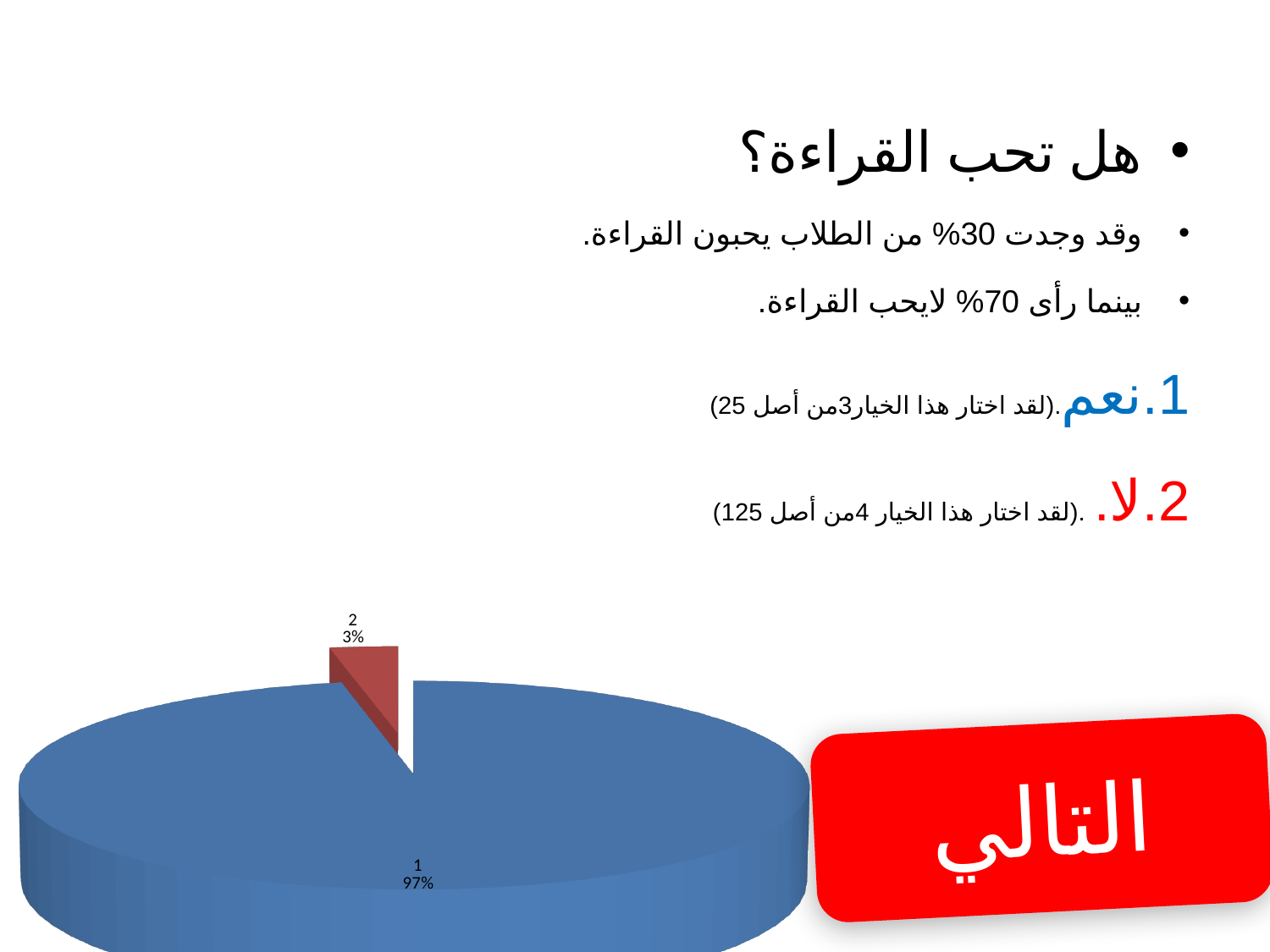
Which slice is larger in the pie chart, slice 1 or slice 2? 1 How many slices does the pie chart have? 2 Which slice of the pie chart is the smallest? 2 What colour is the slice labelled 2 in the pie chart? red What kind of chart is shown on the slide? pie chart What colour is the largest slice of the pie chart? blue What percentage is shown for slice 2 in the pie chart? 3% Which slice of the pie chart is the largest? 1 What percentage is shown for slice 1 in the pie chart? 97% What share of the pie does slice 2 represent? 3% What is the difference in percentage points between slice 1 and slice 2 in the pie chart? 94